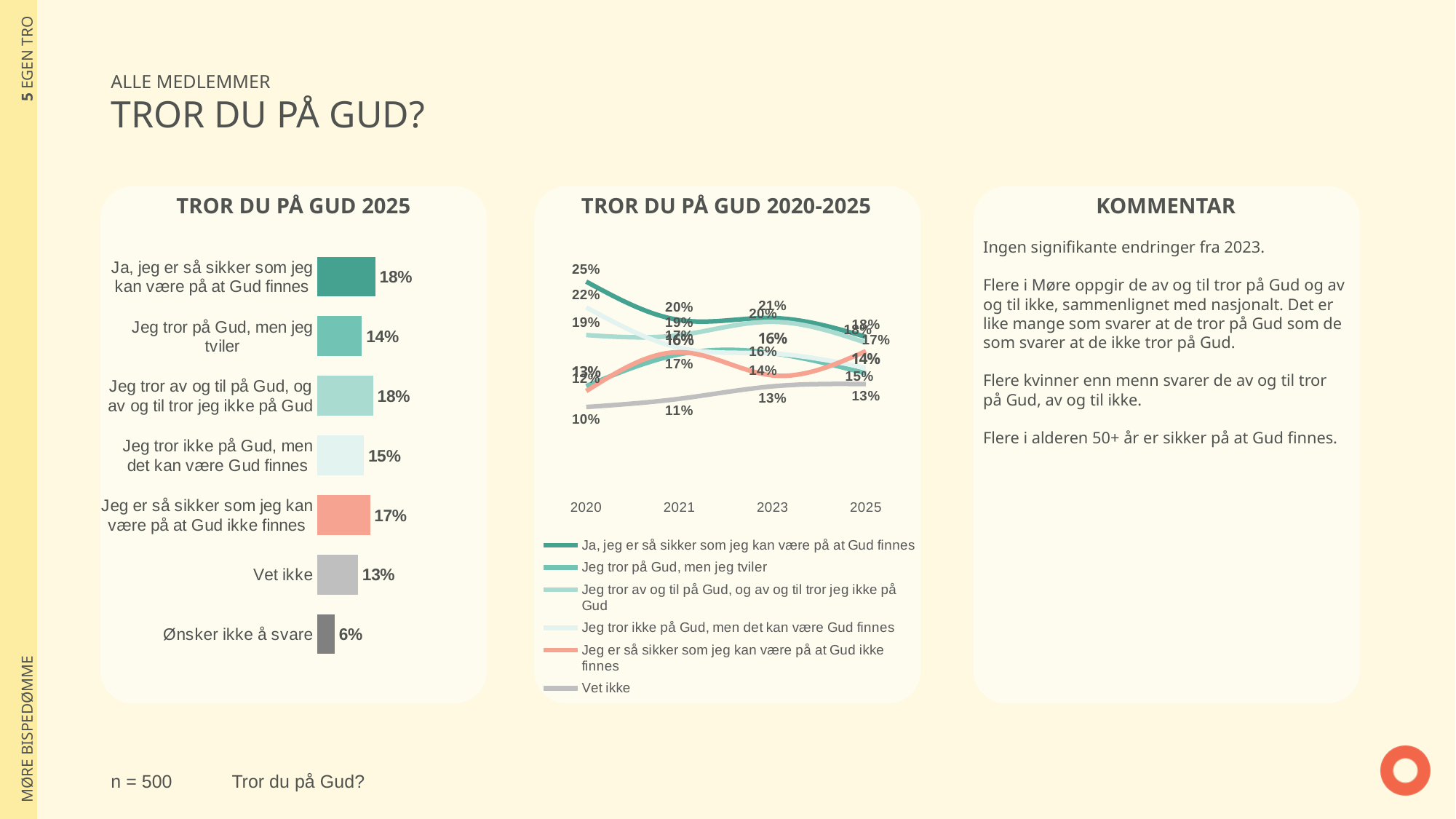
In the chart 'TROR DU PÅ GUD 2025', what is the value for 'Vet ikke'? 13% In the chart 'TROR DU PÅ GUD 2025', which category has the lowest value? Ønsker ikke å svare In the chart 'TROR DU PÅ GUD 2020-2025', does the 'Vet ikke' series rise or fall from 2020 to 2025? Rise How many series does the legend of the chart 'TROR DU PÅ GUD 2020-2025' list? 6 In the chart 'TROR DU PÅ GUD 2020-2025', what is the value for 'Ja, jeg er så sikker som jeg kan være på at Gud finnes' in 2020? 25% How many categories are shown in the chart 'TROR DU PÅ GUD 2025'? 7 In the chart 'TROR DU PÅ GUD 2025', what is the value for 'Jeg tror på Gud, men jeg tviler'? 14% In the chart 'TROR DU PÅ GUD 2025', what is the value for 'Jeg er så sikker som jeg kan være på at Gud ikke finnes'? 17% In the chart 'TROR DU PÅ GUD 2025', which is larger: 'Jeg tror på Gud, men jeg tviler' or 'Jeg er så sikker som jeg kan være på at Gud ikke finnes'? Jeg er så sikker som jeg kan være på at Gud ikke finnes In the chart 'TROR DU PÅ GUD 2020-2025', what is the value for 'Vet ikke' in 2020? 10% What kind of chart is 'TROR DU PÅ GUD 2025'? Bar chart In the chart 'TROR DU PÅ GUD 2025', what is the difference between 'Jeg tror ikke på Gud, men det kan være Gud finnes' and 'Ønsker ikke å svare'? 9%